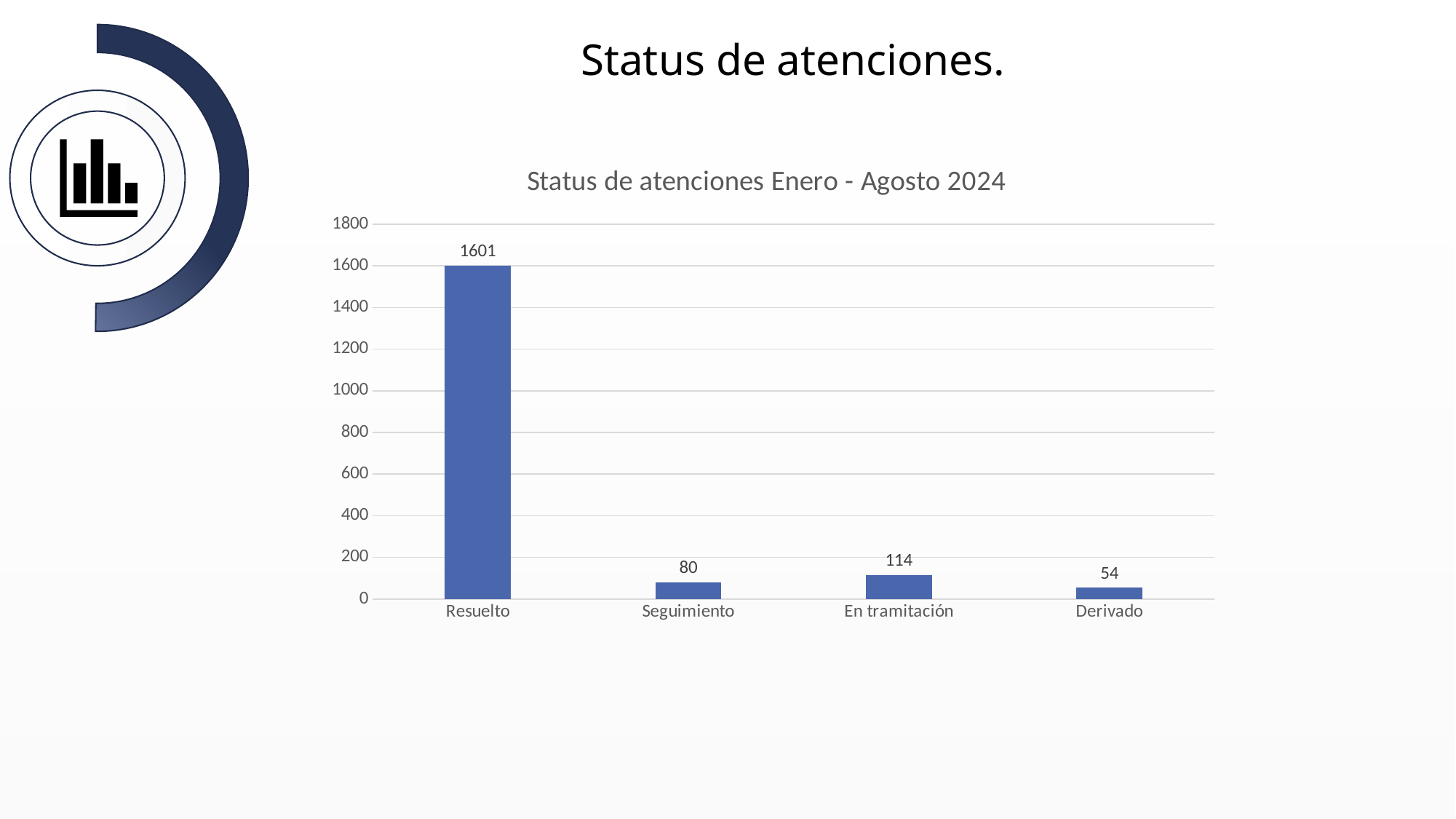
Which category has the highest value? Resuelto Which category has the lowest value? Derivado Which is larger, the value for Seguimiento or the value for Derivado? Seguimiento What is the difference between the values for Resuelto and En tramitación? 1487 What is the value for Seguimiento? 80 What kind of chart is shown on the slide? Bar chart What is the difference between the values for En tramitación and Seguimiento? 34 How many categories are shown on the x axis? 4 What is the value for Derivado? 54 What is the title of the chart? Status de atenciones Enero - Agosto 2024 What is the value for Resuelto? 1601 What is the value for En tramitación? 114